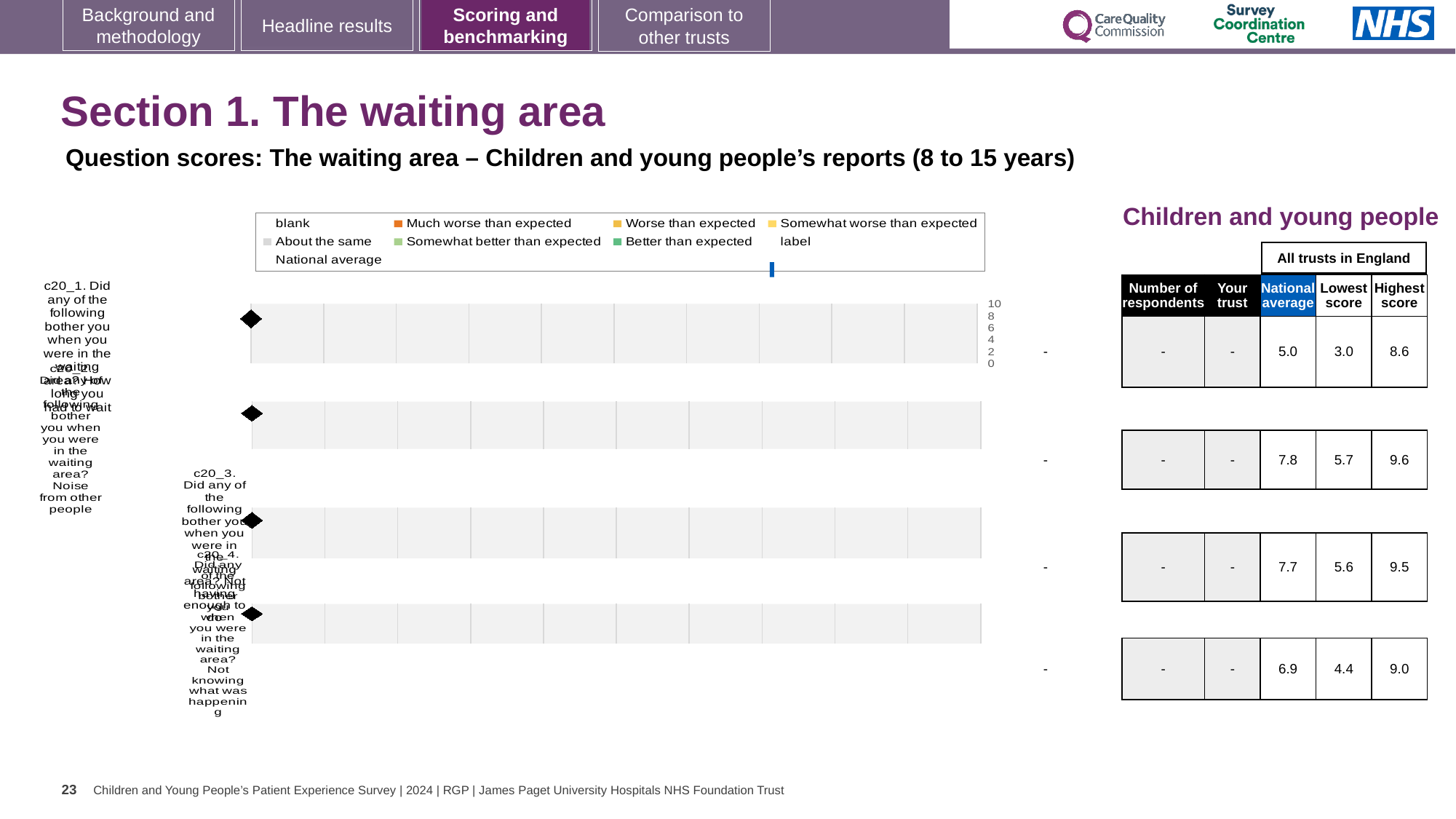
How many entries does the chart legend list? 9 In the table to the right of the chart, what is the difference between the Highest score and Lowest score for the first question (c20_1)? 5.6 In the table to the right of the chart, which question has the highest National average? c20_2 (how long you had to wait) What colour does the legend use for 'Much worse than expected'? orange What marker shape does the chart use for the National average? diamond In the table to the right of the chart, which question has the lowest National average? c20_1 (waiting area) How many question categories (bars) does the chart show? 4 In the table to the right of the chart, what is the National average for the first question (c20_1, waiting area)? 5.0 In the table to the right of the chart, what is the Highest score for the second question (c20_2, how long you had to wait)? 9.6 In the table to the right of the chart, what is the National average for the fourth question (c20_4, not knowing what was happening)? 6.9 In the table to the right of the chart, what is the Lowest score for the third question (c20_3, noise from other people)? 5.6 What kind of chart is shown on the slide? bar chart